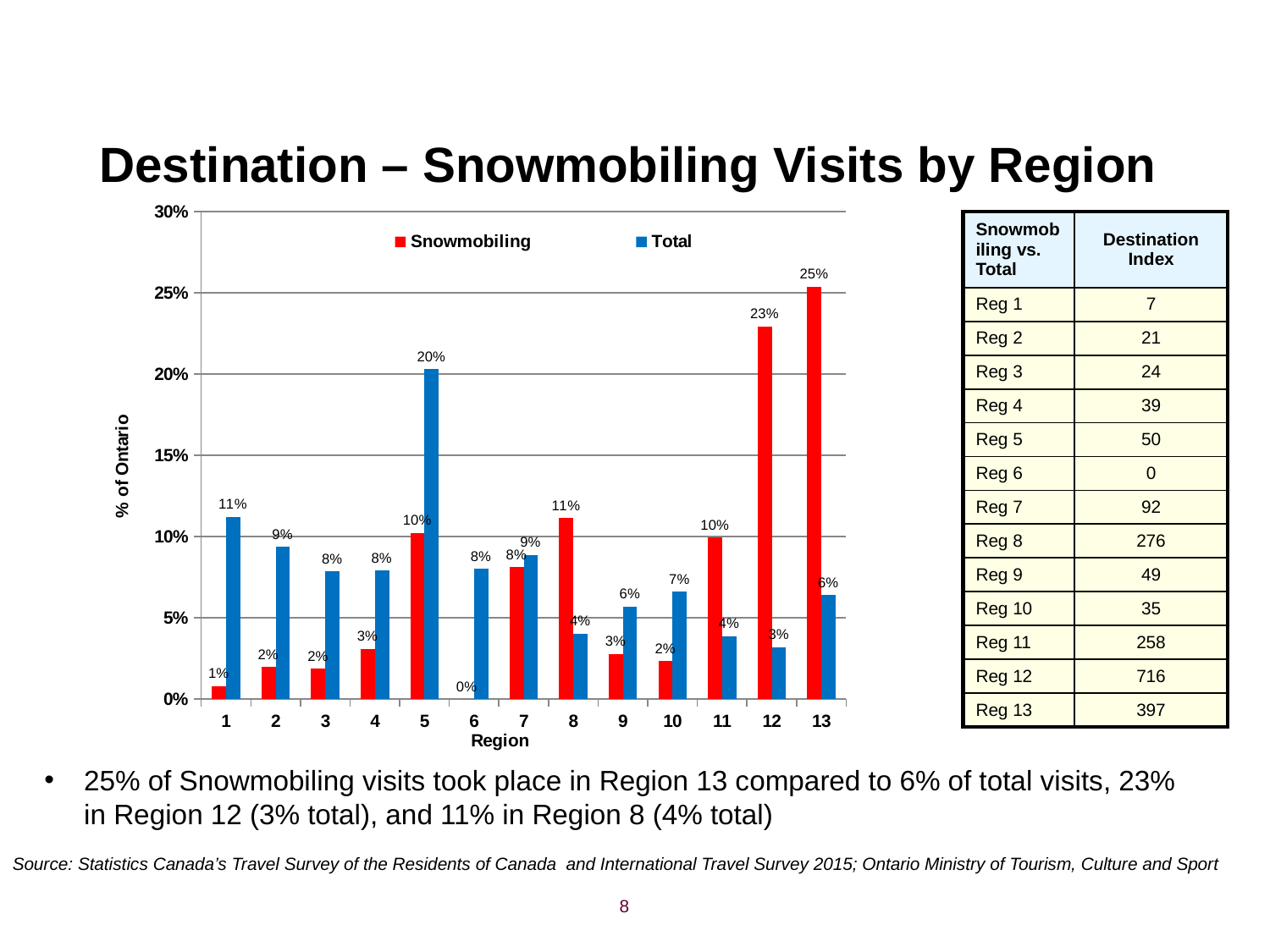
What kind of chart is shown on the slide? Bar chart Which region has the highest Total value? Region 5 How many regions are shown on the x axis of the chart? 13 How many series does the chart legend list? 2 What is the difference between the Snowmobiling and Total values for Region 12? 20 percentage points What is the Total value for Region 5? 20% What is the Snowmobiling value for Region 13? 25% Which region has the lowest Snowmobiling value? Region 6 Which region has the highest Snowmobiling value? Region 13 Which series is shown in red in the chart? Snowmobiling For Region 8, which is larger, the Snowmobiling value or the Total value? Snowmobiling What is the Snowmobiling value for Region 6? 0%